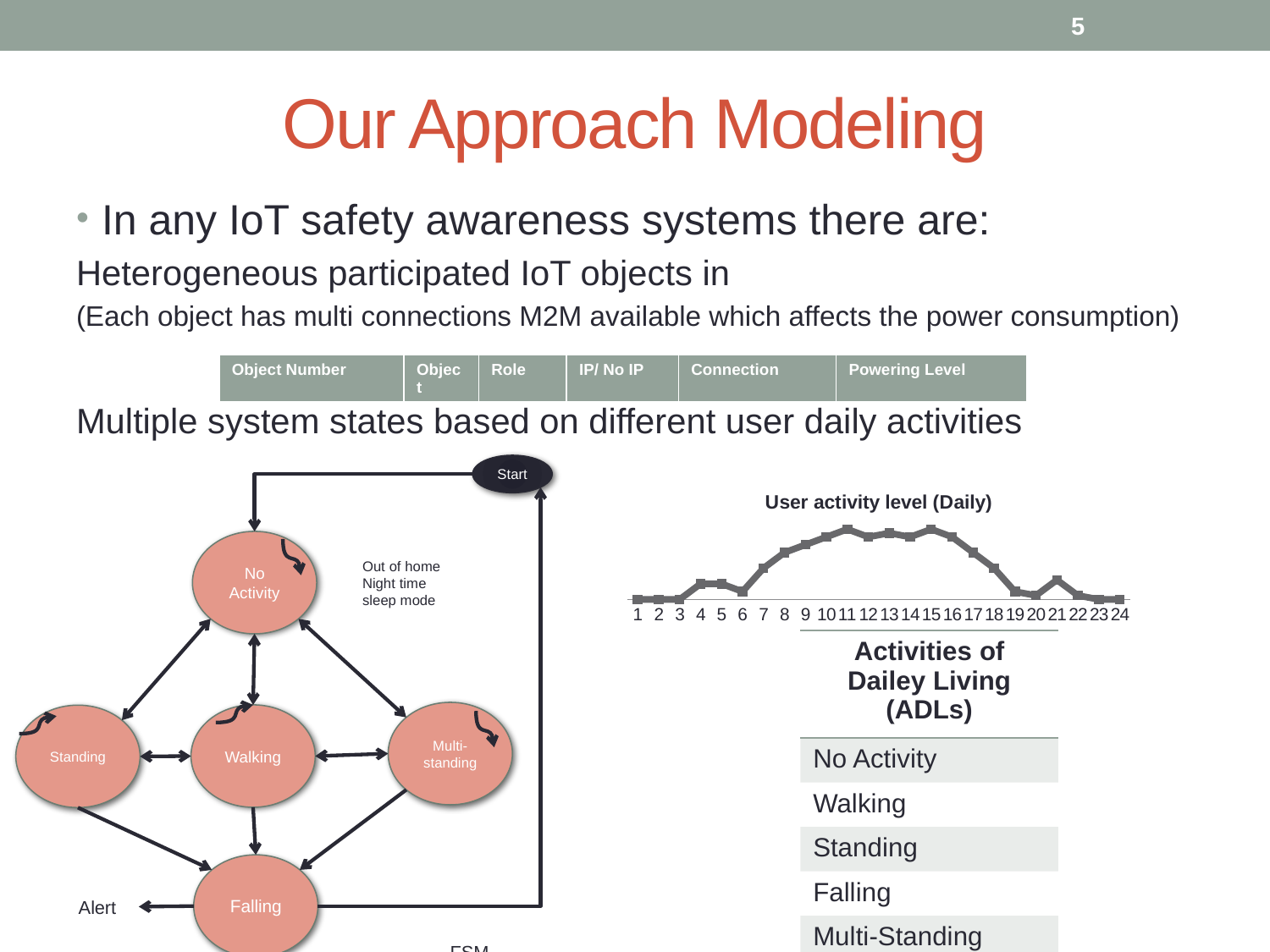
What is the title of the chart on the right side of the slide? User activity level (Daily) What kind of chart is the 'User activity level (Daily)' chart? line chart In the 'User activity level (Daily)' chart, which is larger, the value at 20 or the value at 21? 21 In the 'User activity level (Daily)' chart, which is larger, the value at 4 or the value at 8? 8 How many points are plotted along the x axis of the 'User activity level (Daily)' chart? 24 In the 'User activity level (Daily)' chart, do the values rise or fall between x = 5 and x = 10? rise In the 'User activity level (Daily)' chart, which is larger, the value at 15 or the value at 23? 15 In the 'User activity level (Daily)' chart, do the values rise or fall between x = 16 and x = 20? fall In the 'User activity level (Daily)' chart, what is the first x-axis label? 1